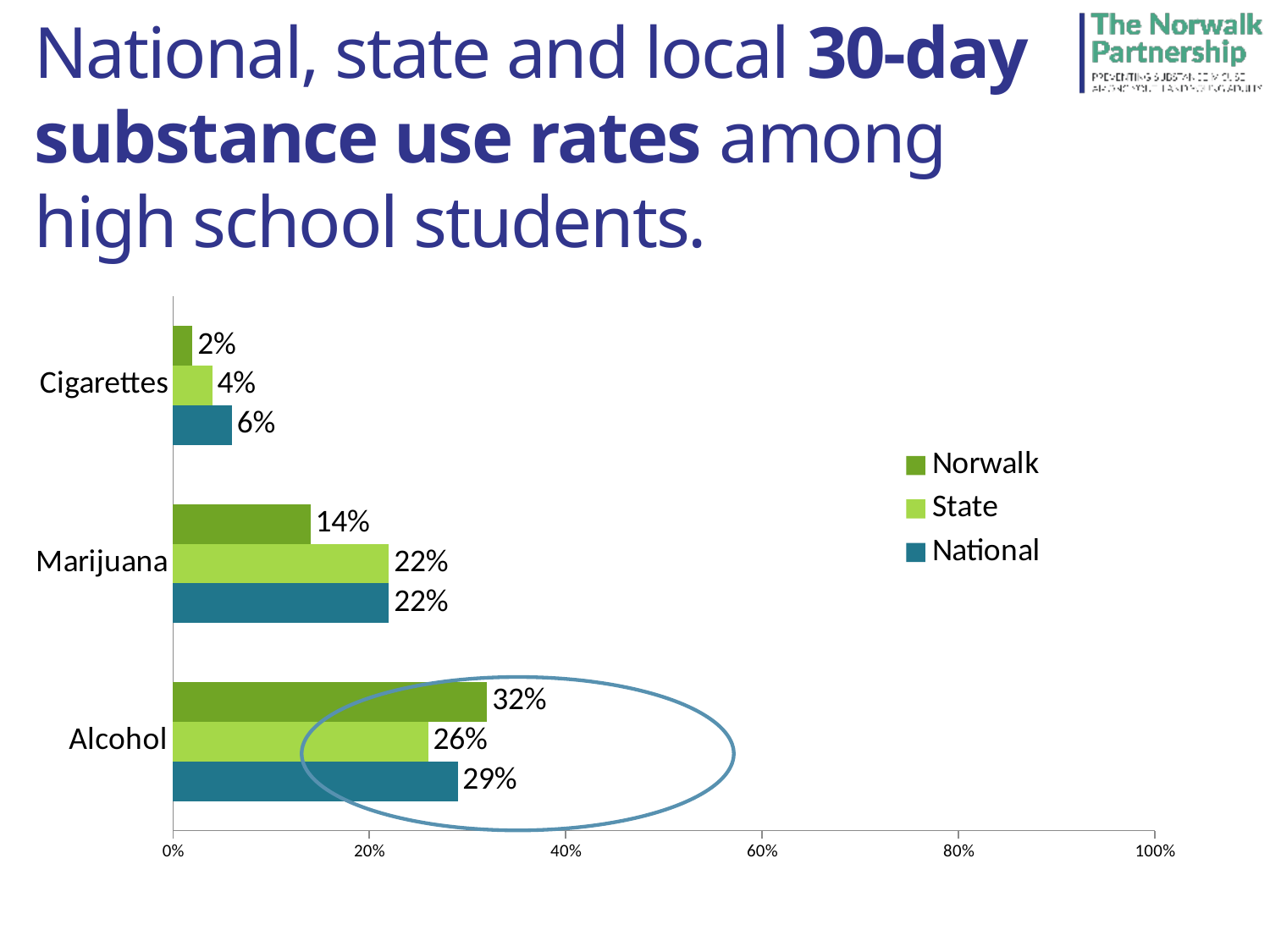
Which category has the lowest National value? Cigarettes What is the Norwalk value for Cigarettes? 2% What kind of chart is shown on the slide? Bar chart What is the difference between the State and Norwalk values for Marijuana? 8% Which category has the highest Norwalk value? Alcohol What is the Norwalk value for Alcohol? 32% What is the difference between the Norwalk and State values for Alcohol? 6% What is the State value for Marijuana? 22% What is the National value for Cigarettes? 6% How many categories are shown on the chart? 3 How many series does the legend list? 3 Which is larger for Alcohol, the Norwalk value or the National value? Norwalk